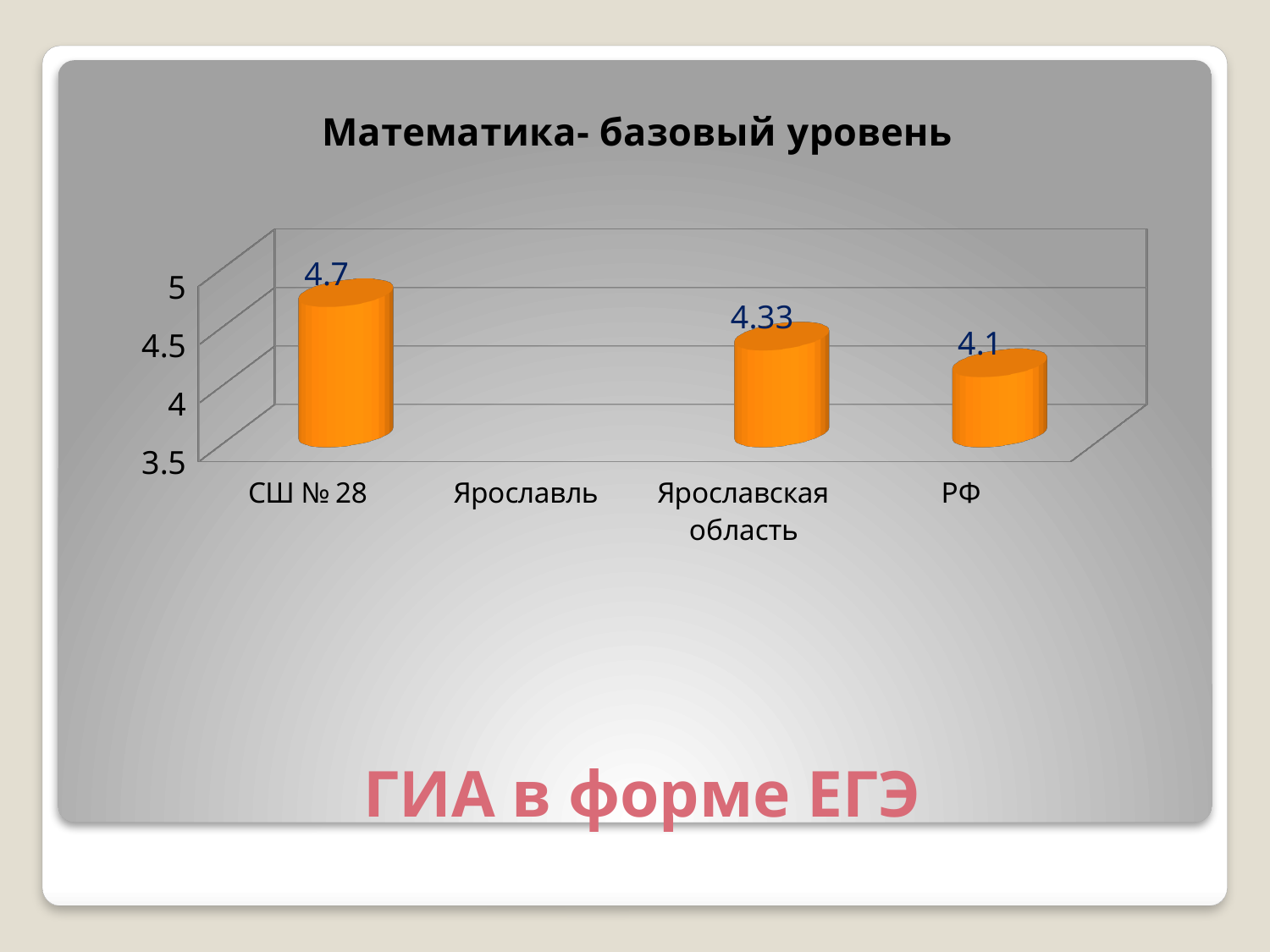
What is the value shown for РФ? 4.1 What is the difference between the values for Ярославская область and РФ? 0.23 Is the value for СШ № 28 greater or less than 4.5? greater What kind of chart is shown on the slide? bar chart What is the difference between the values for СШ № 28 and РФ? 0.6 Which of the plotted bars has the lowest value? РФ Which is larger, the value for Ярославская область or the value for РФ? Ярославская область What is the value shown for Ярославская область? 4.33 How many bars are plotted on the chart? 3 What is the value shown for СШ № 28? 4.7 Which category has the highest value? СШ № 28 What is the title of the chart? Математика- базовый уровень